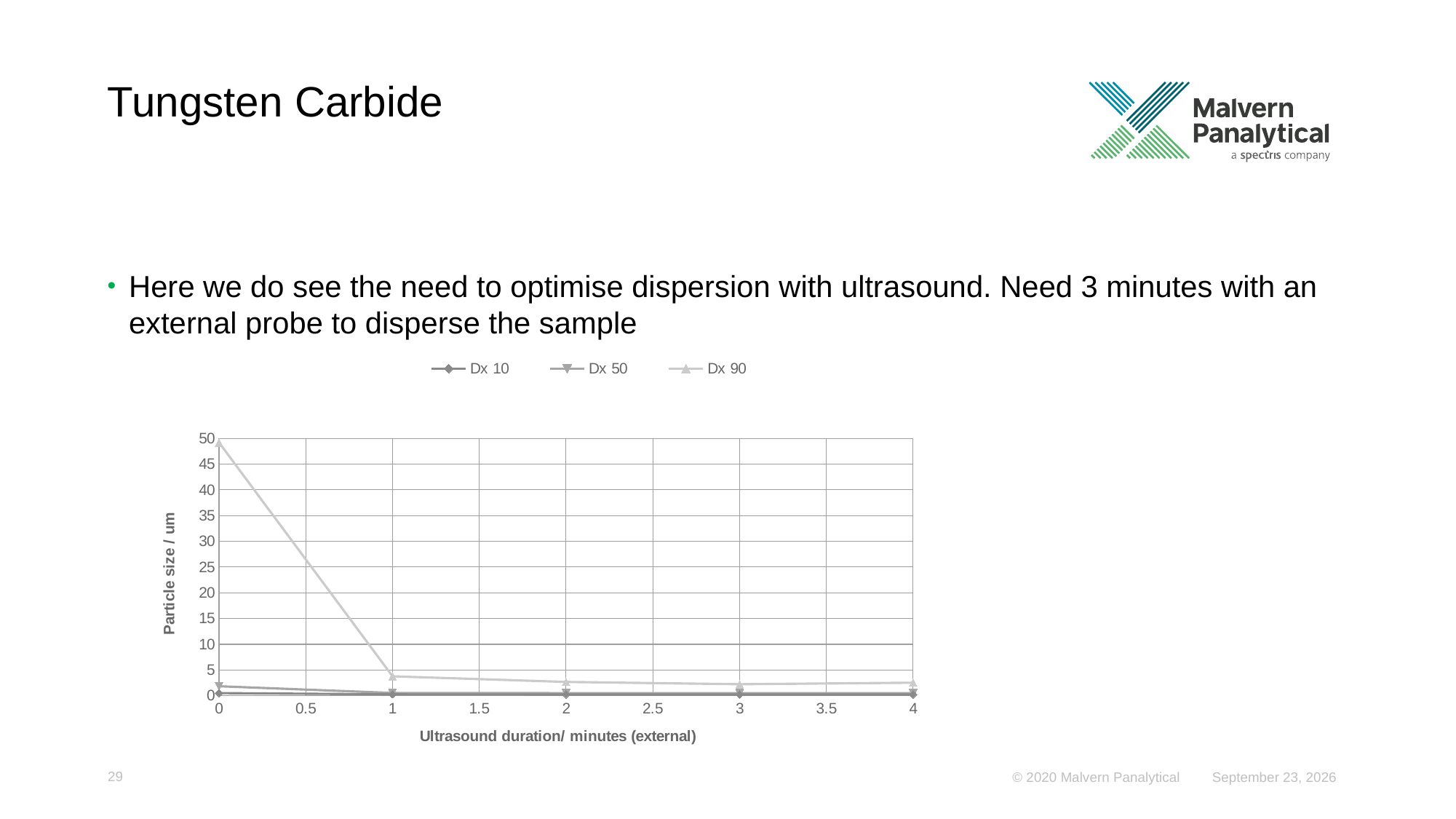
Does the Dx 90 series rise or fall as ultrasound duration increases from 0 to 4 minutes? fall At which ultrasound duration is the Dx 90 value highest? 0 Is the Dx 90 value at 4 minutes greater or less than 10? less Which series has the highest value at 0 minutes of ultrasound? Dx 90 Is the Dx 50 value at 0 minutes greater or less than 5? less How many series does the chart legend list? 3 How many data points are plotted for the Dx 90 series? 5 Which series are listed in the chart legend? Dx 10, Dx 50, Dx 90 Is the Dx 90 value at 0 minutes greater or less than 40? greater What kind of chart is shown on the slide? line chart What is the title of the x axis of the chart? Ultrasound duration/ minutes (external) At 0 minutes, which is larger: the Dx 90 value or the Dx 10 value? Dx 90